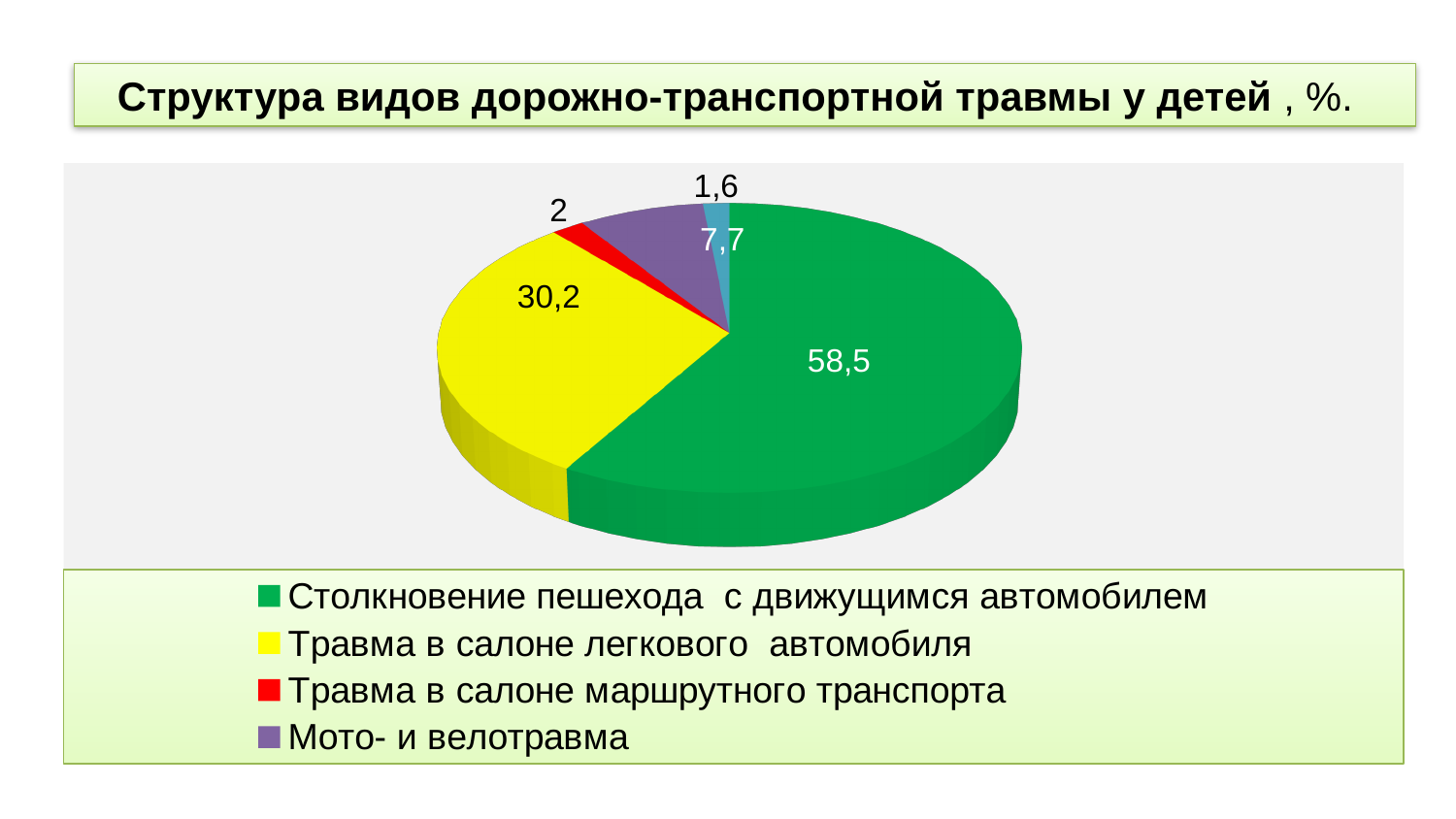
What is the smallest value printed on the pie chart? 1,6 What value is shown for Мото- и велотравма? 7,7 What kind of chart is shown on the slide? Pie chart What percentage of the pie is labelled for Столкновение пешехода с движущимся автомобилем? 58,5 What value is shown for Травма в салоне легкового автомобиля? 30,2 What is the difference between the values for Столкновение пешехода с движущимся автомобилем and Травма в салоне легкового автомобиля? 28,3 What is the difference between the values for Мото- и велотравма and Травма в салоне маршрутного транспорта? 5,7 Which category has the largest slice of the pie? Столкновение пешехода с движущимся автомобилем What value is shown for Травма в салоне маршрутного транспорта? 2 How many slices does the pie chart have? 5 How many entries does the legend list? 4 Which is larger: Мото- и велотравма or Травма в салоне маршрутного транспорта? Мото- и велотравма